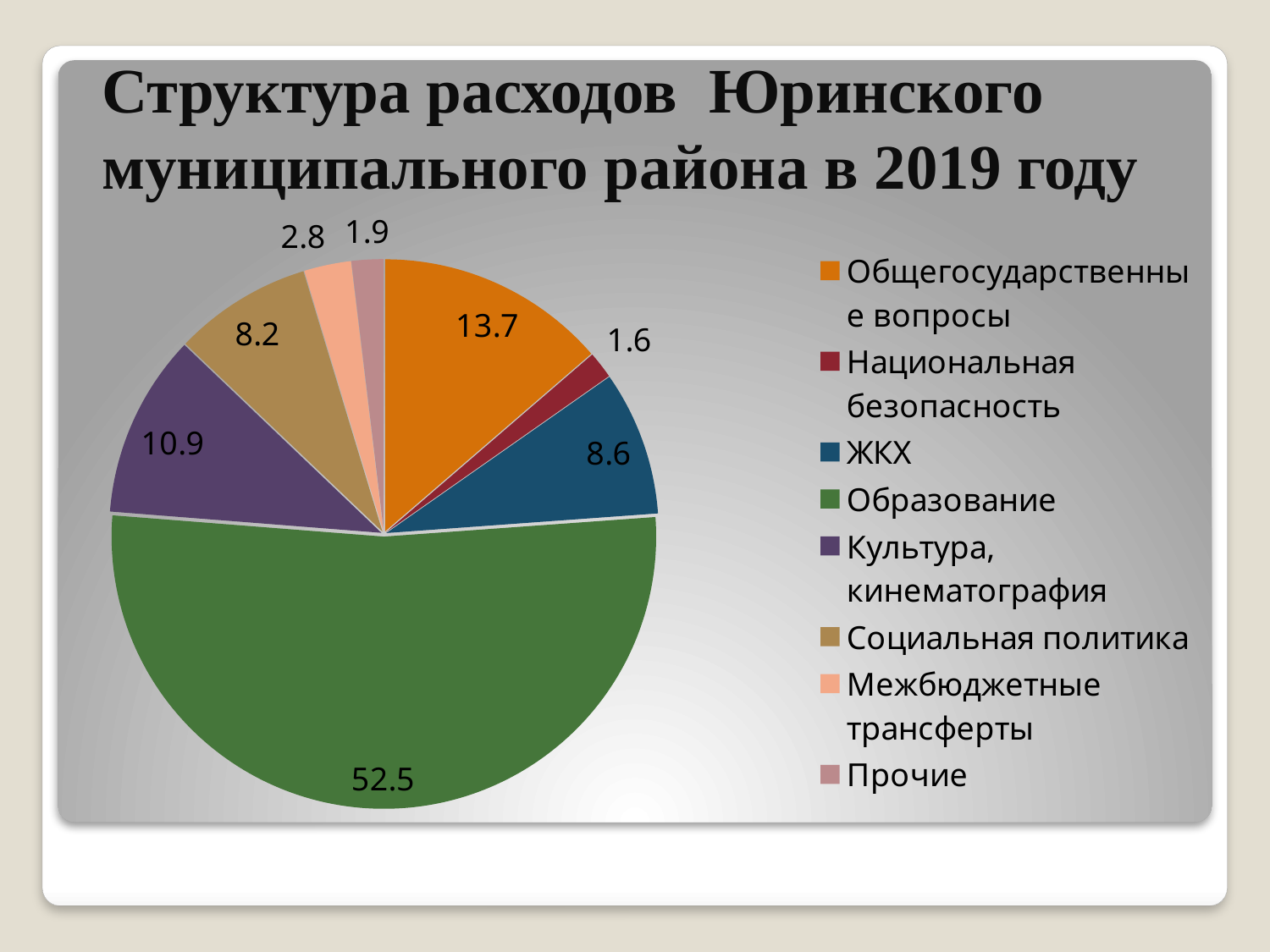
How many categories does the pie chart have? 8 What is the difference between the values for Образование and Общегосударственные вопросы? 38.8 What is the value for Общегосударственные вопросы? 13.7 What is the value for Культура, кинематография? 10.9 Which category has the smallest slice of the pie? Национальная безопасность What is the value for ЖКХ? 8.6 What is the value for Образование? 52.5 What colour is the slice for Образование? Green What is the value for Межбюджетные трансферты? 2.8 Which category has the largest slice of the pie? Образование What kind of chart is shown on the slide? Pie chart Which is larger, the value for Культура, кинематография or the value for Социальная политика? Культура, кинематография